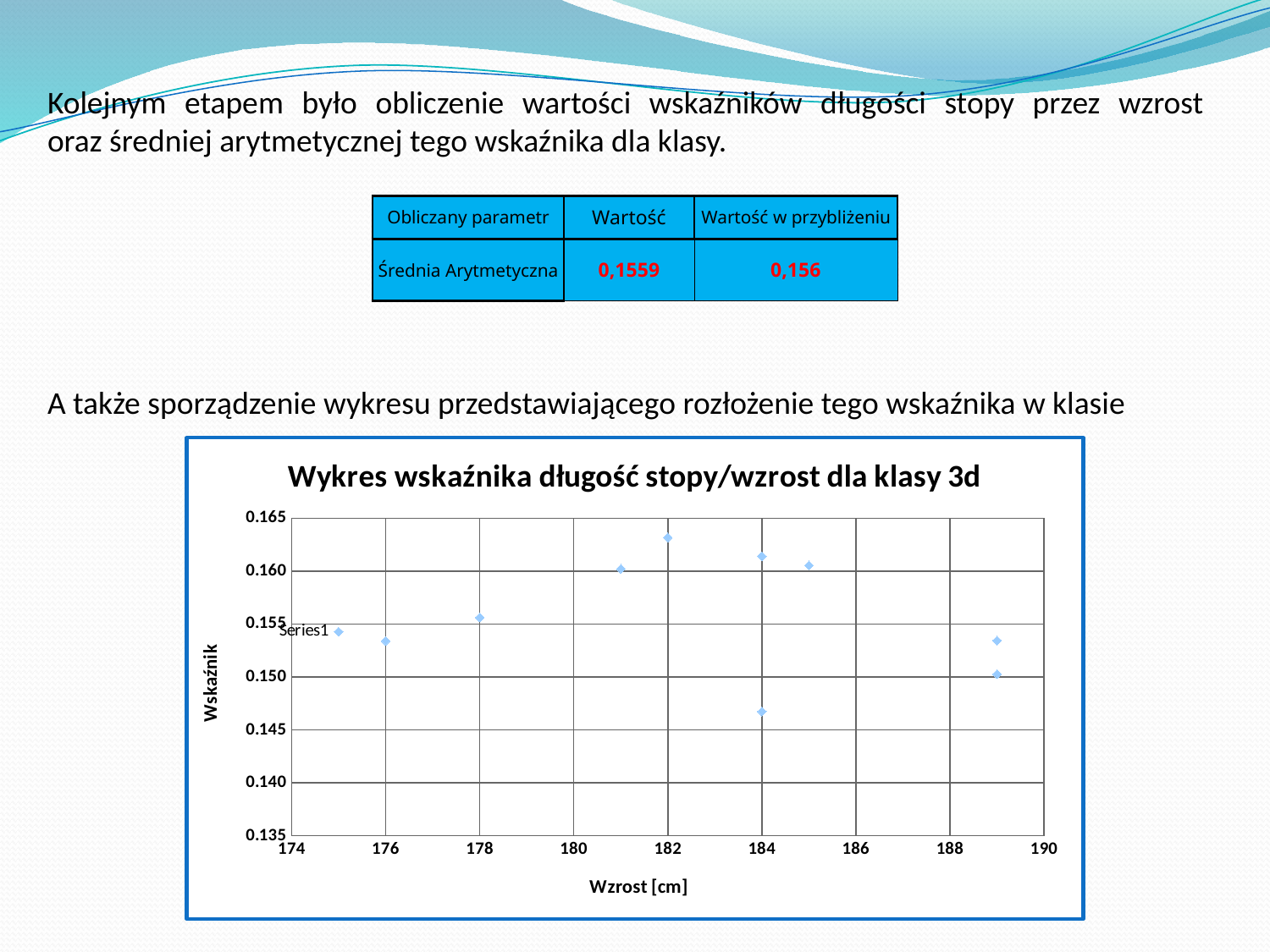
Which has the larger Wskaźnik value: the point at 182 cm or the point at 176 cm? 182 cm How many data points are plotted on the chart? 10 What kind of chart is shown on the slide? scatter chart Is the Wskaźnik value for the point at 176 cm greater or less than 0.155? less Is the lowest Wskaźnik value plotted at 184 cm greater or less than 0.150? less What is the label of the x axis? Wzrost [cm] Which has the larger Wskaźnik value: the point at 178 cm or the point at 176 cm? 178 cm At which height (Wzrost) is the lowest Wskaźnik value plotted? 184 Is the Wskaźnik value for the point at 182 cm greater or less than 0.160? greater What is the title of the chart? Wykres wskaźnika długość stopy/wzrost dla klasy 3d At which height (Wzrost) is the highest Wskaźnik value plotted? 182